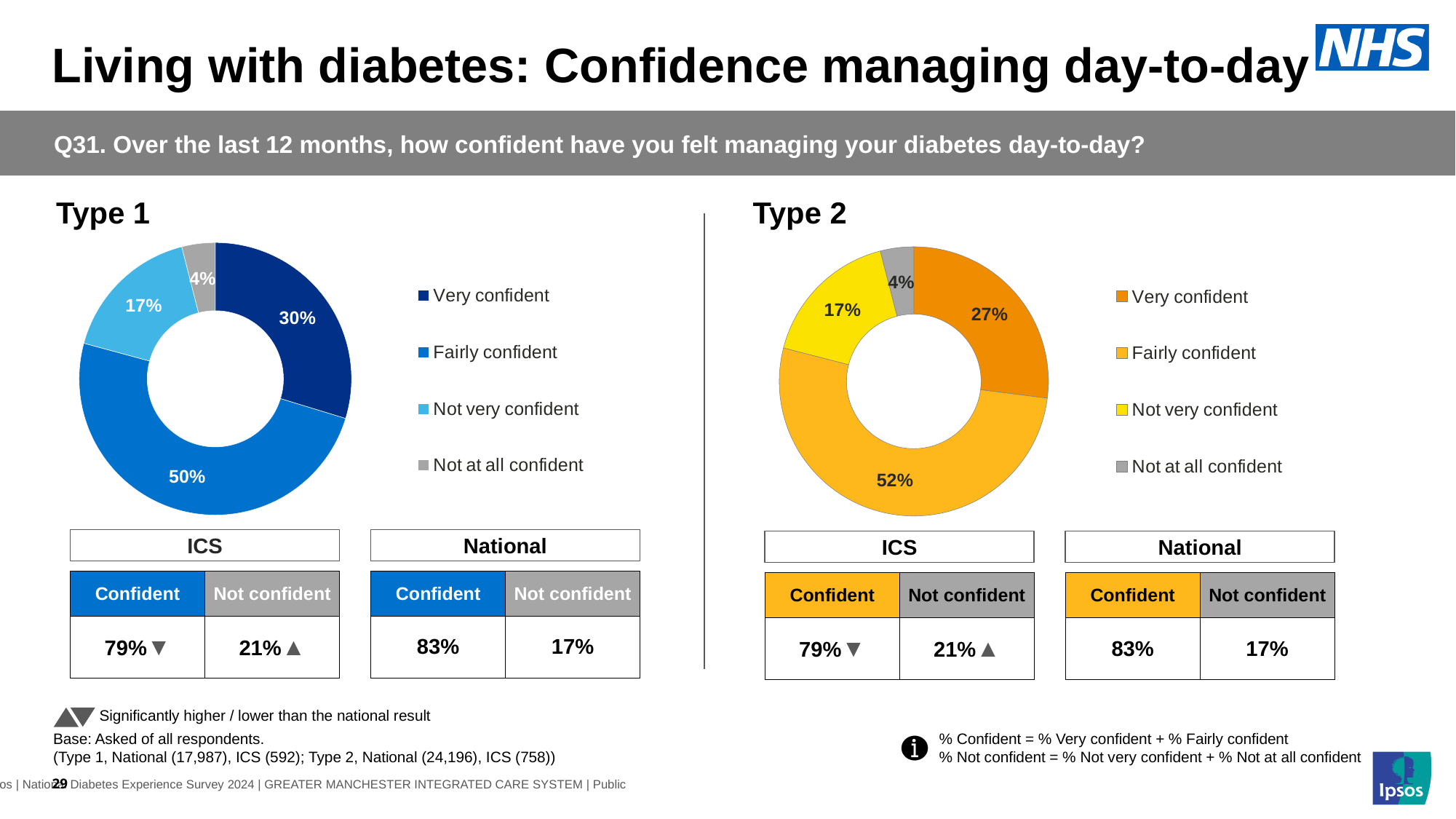
In the Type 1 chart, what percentage of respondents were Very confident? 30% In the Type 2 chart, which is larger: Very confident or Not very confident? Very confident What kind of chart is used for Type 2? Doughnut chart In the Type 2 chart, which category has the smallest share? Not at all confident How many entries does the legend of the Type 2 chart list? 4 In the Type 1 chart, what is the difference between the Fairly confident and Very confident shares? 20 percentage points In the Type 2 chart, what percentage of respondents were Fairly confident? 52% In the Type 1 chart, what colour is the Very confident segment? Dark blue In the Type 2 chart, what is the combined share of Very confident and Fairly confident? 79% How many categories does the Type 1 chart show? 4 In the Type 1 chart, what percentage of respondents were Not very confident? 17% In the Type 1 chart, which category has the largest share? Fairly confident